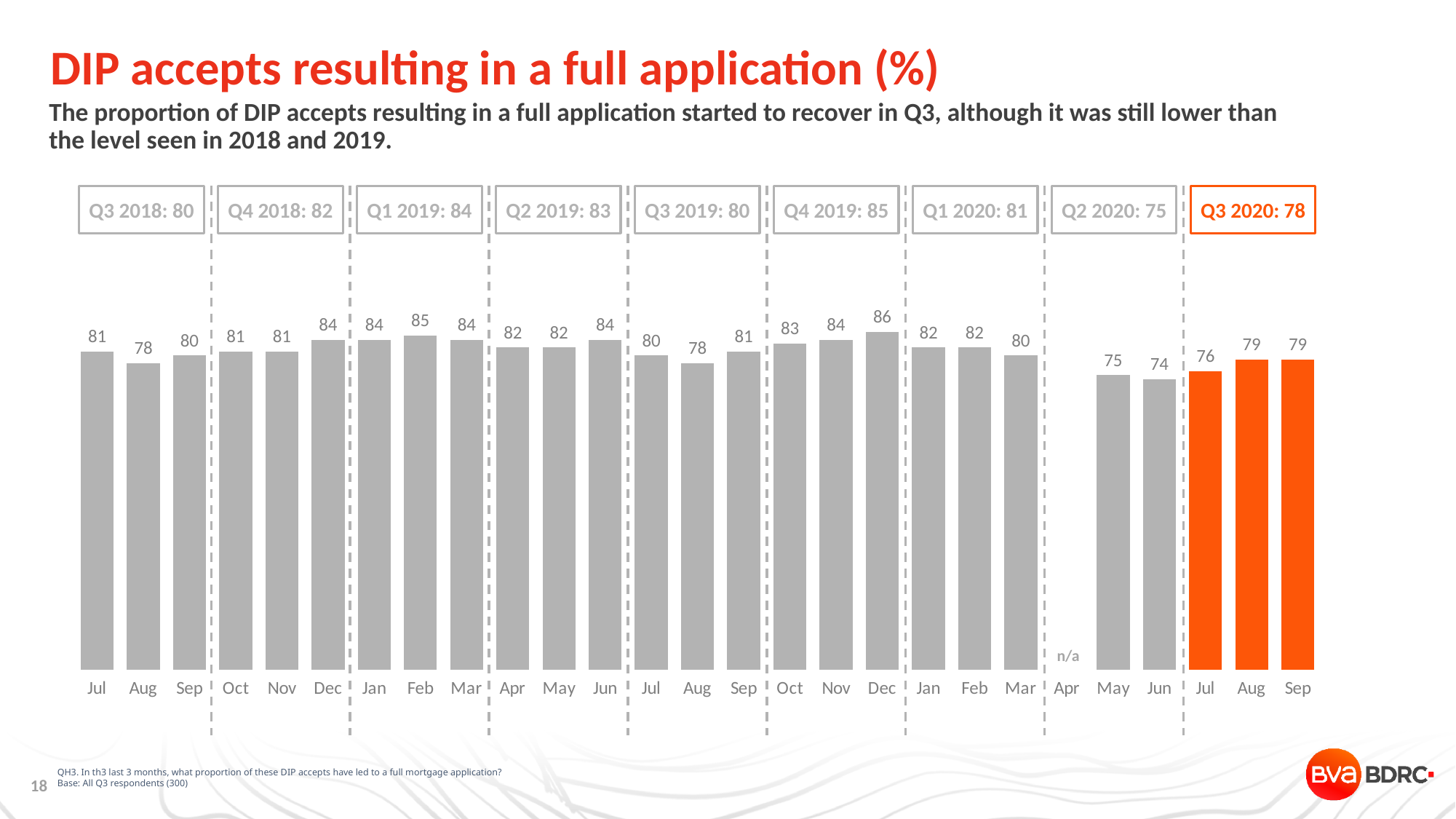
Which month has the lowest value on the chart? Jun (Q2 2020) What is the value for Feb in Q1 2019? 85 What kind of chart is shown on the slide? Bar chart What is the difference between the value for Dec in Q4 2019 and the value for Jun in Q2 2020? 12 Which is larger, the value for Jul in Q3 2020 or the value for Aug in Q3 2020? Aug in Q3 2020 Which month has the highest value on the chart? Dec (Q4 2019) Which month on the chart is marked n/a with no bar? Apr (Q2 2020) What is the value for Jun in Q2 2020? 74 What is the value for Dec in Q4 2019? 86 What is the value for Sep in Q3 2020? 79 How many quarterly summary boxes are shown above the chart? 9 What is the quarterly figure shown in the box for Q3 2020? 78